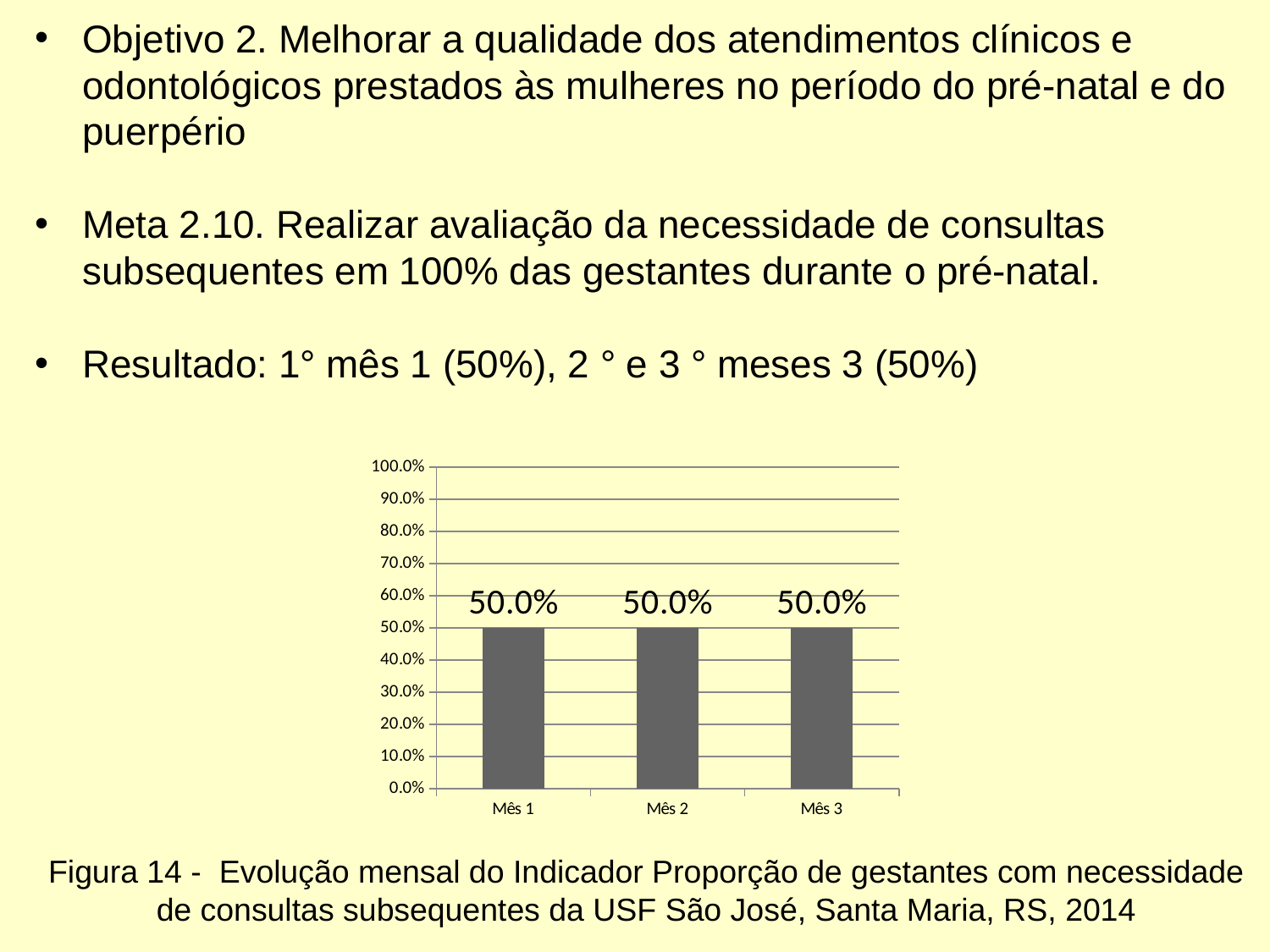
What kind of chart is shown on the slide? bar chart Is the value for Mês 1 greater or less than 40.0%? greater What is the value for Mês 2? 50.0% How many categories (months) are shown on the x axis of the chart? 3 What is the highest value shown on the chart's y axis? 100.0% Is the value for Mês 2 greater or less than 60.0%? less What figure number is given in the caption below the chart? Figura 14 What is the value for Mês 3? 50.0% What is the difference between the values for Mês 3 and Mês 1? 0.0% What is the value for Mês 1? 50.0% Do the values rise, fall, or stay the same from Mês 1 to Mês 3? stay the same